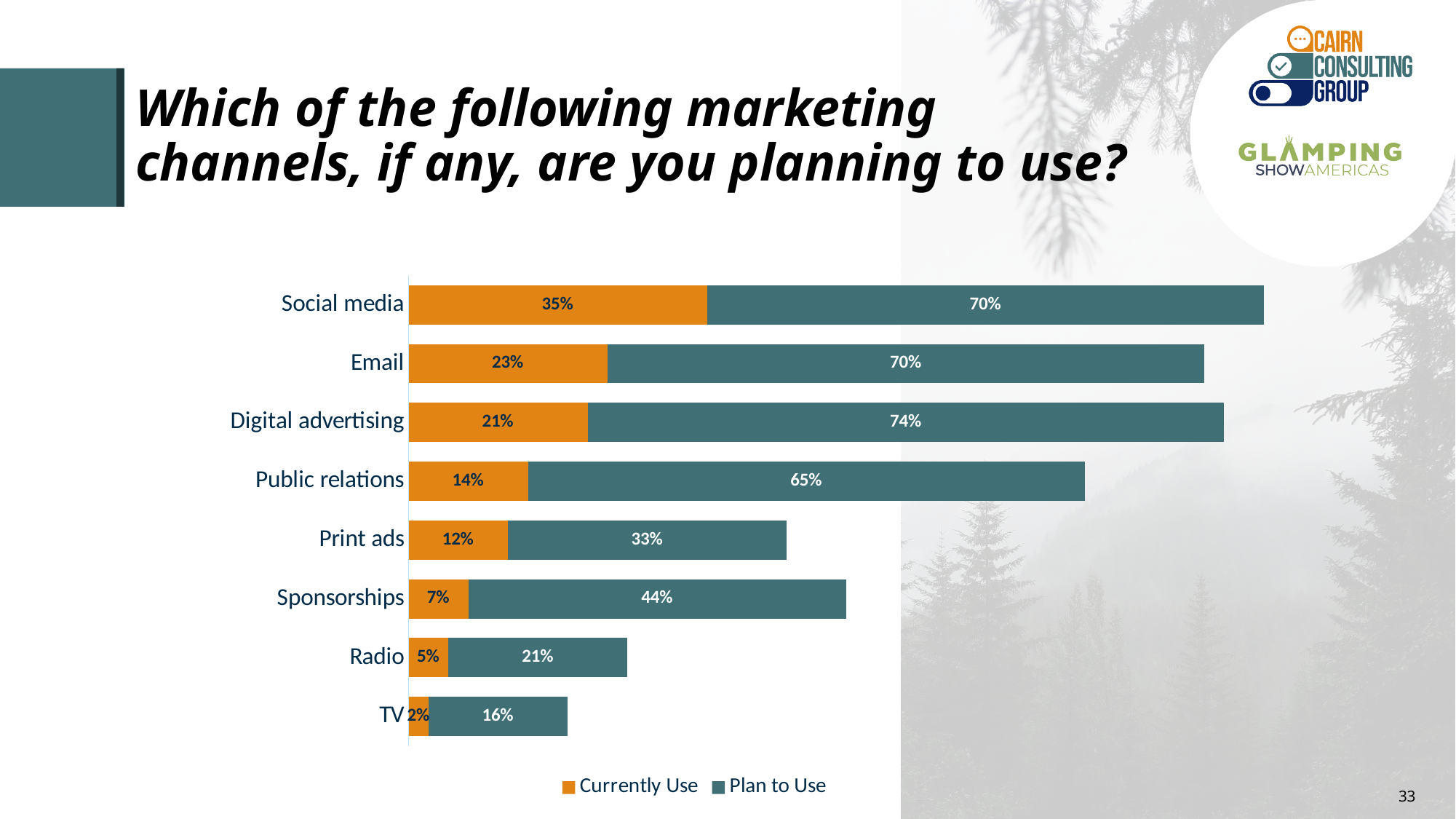
Which is larger: the 'Plan to Use' value for print ads or for sponsorships? Sponsorships Which colour represents 'Currently Use' in the chart? Orange What percentage of respondents currently use social media? 35% What is the 'Plan to Use' value for sponsorships? 44% Which marketing channel has the lowest 'Plan to Use' value? TV What kind of chart is shown on the slide? Stacked bar chart What is the difference between the 'Plan to Use' and 'Currently Use' values for public relations? 51% What percentage of respondents plan to use digital advertising? 74% How many marketing channels are shown in the chart? 8 What is the total of the stacked bar for Email? 93% How many series does the legend list? 2 Which marketing channel has the highest 'Currently Use' value? Social media